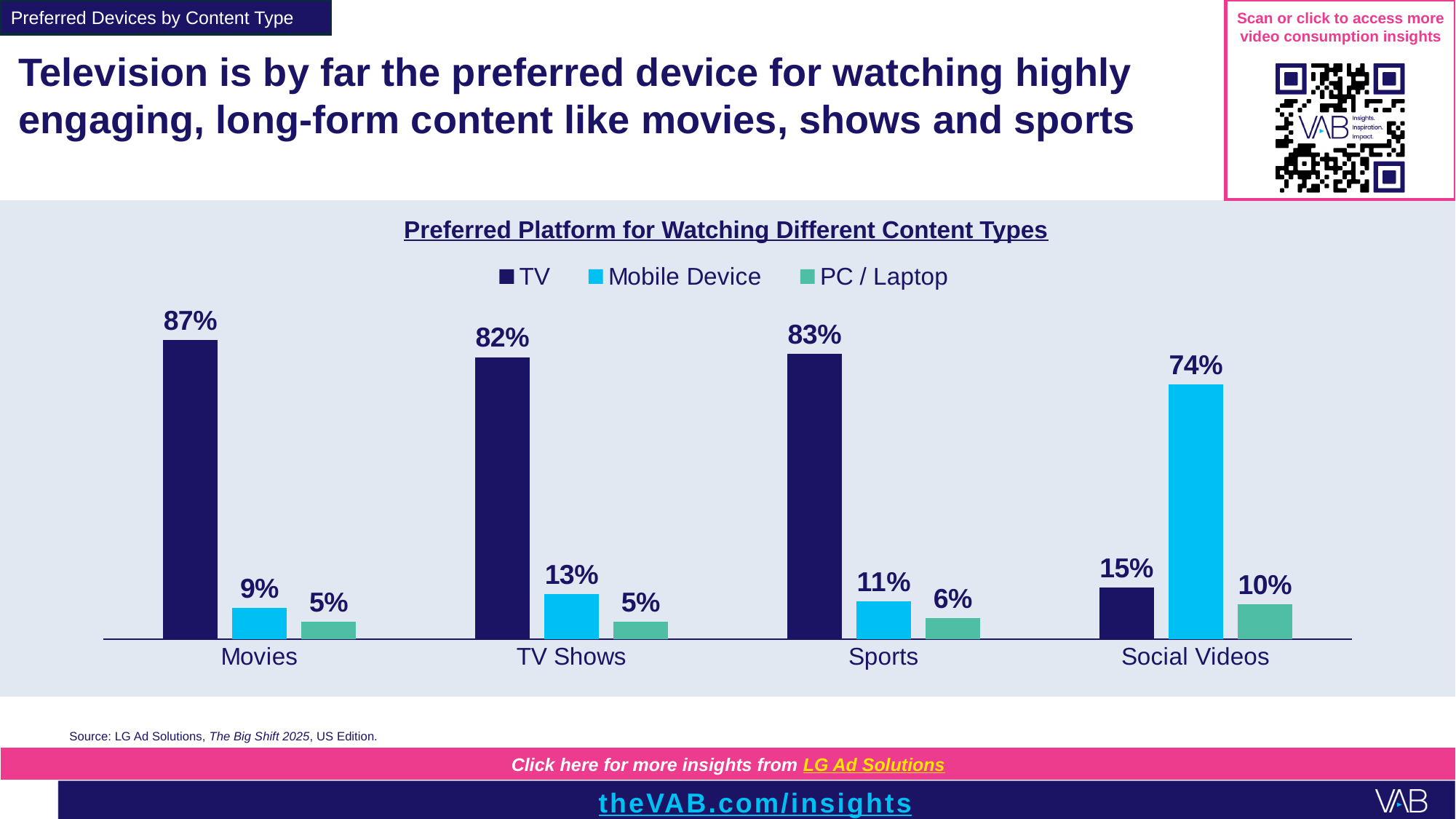
For which content type is the TV value highest? Movies What percentage prefer TV for watching Movies? 87% How many series does the legend list? 3 How many content types are shown on the x axis? 4 What percentage prefer a PC / Laptop for watching Sports? 6% What kind of chart is shown? Bar chart What percentage prefer a Mobile Device for watching Social Videos? 74% What is the title of the chart? Preferred Platform for Watching Different Content Types What percentage prefer a Mobile Device for watching TV Shows? 13% Which is larger for Sports: the TV value or the Mobile Device value? TV For which content type is the TV value lowest? Social Videos What is the difference between the TV value for Movies and the TV value for TV Shows? 5%